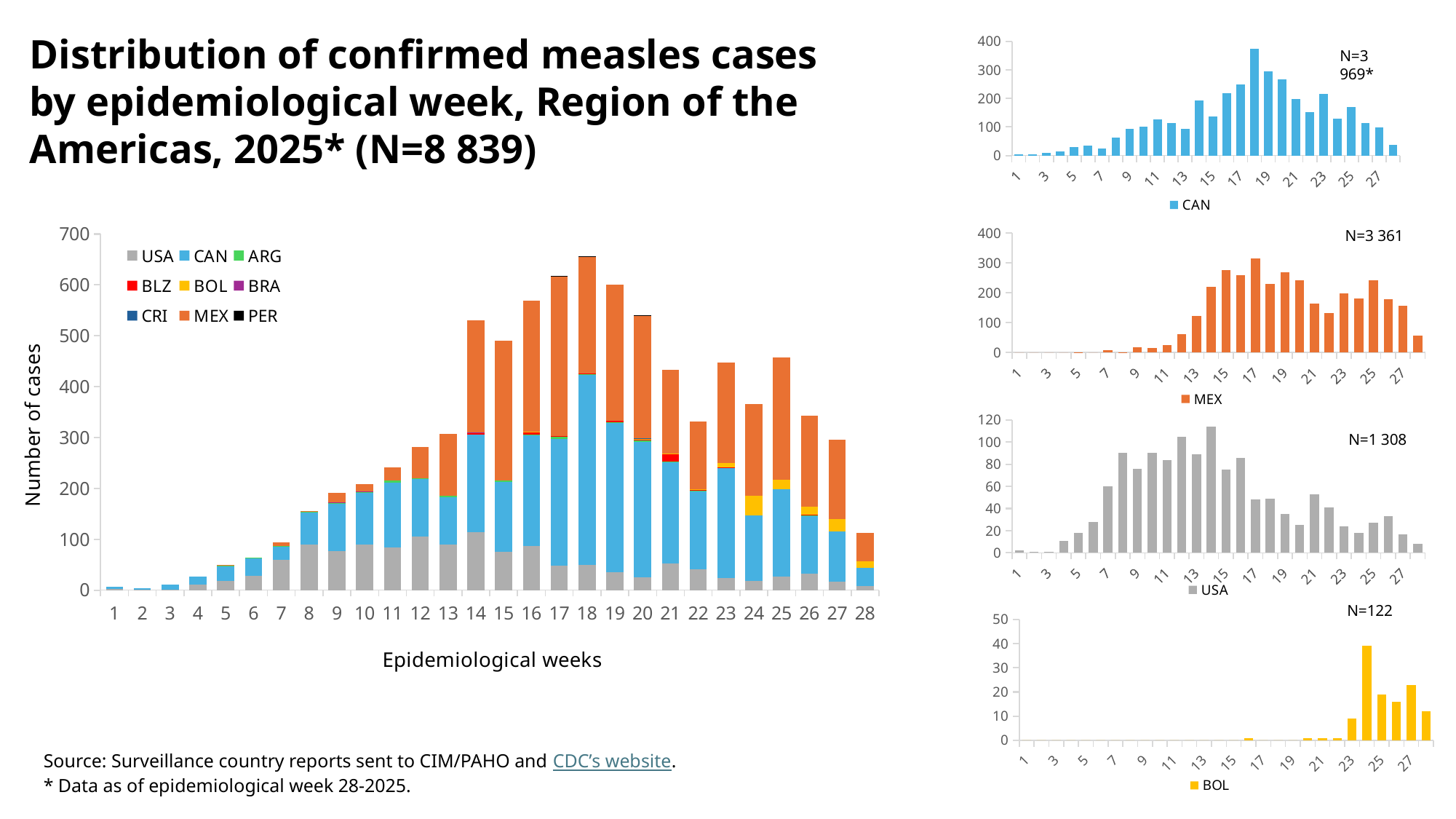
In the main stacked bar chart on the left, how many epidemiological weeks are shown on the x axis? 28 In the CAN chart at the top right, what is the N value printed on the chart? N=3 969* In the main stacked bar chart on the left, is the total for week 18 greater or less than 600? greater What kind of chart is the main chart on the left, titled 'Distribution of confirmed measles cases by epidemiological week, Region of the Americas, 2025*'? Stacked bar chart In the main stacked bar chart on the left, how many series does the legend list? 9 In the main stacked bar chart on the left, is the total for week 28 greater or less than 200? less In the BOL chart at the bottom right, which epidemiological week has the highest number of cases? 24 In the USA chart on the right, is the value for week 14 greater or less than 100? greater In the CAN chart at the top right, do the values rise or fall from week 19 to week 28? Fall In the main stacked bar chart on the left, which is larger, the total for week 14 or the total for week 15? Week 14 In the main stacked bar chart on the left, which epidemiological week has the highest total number of cases? 18 In the MEX chart on the right, which epidemiological week has the highest number of cases? 17